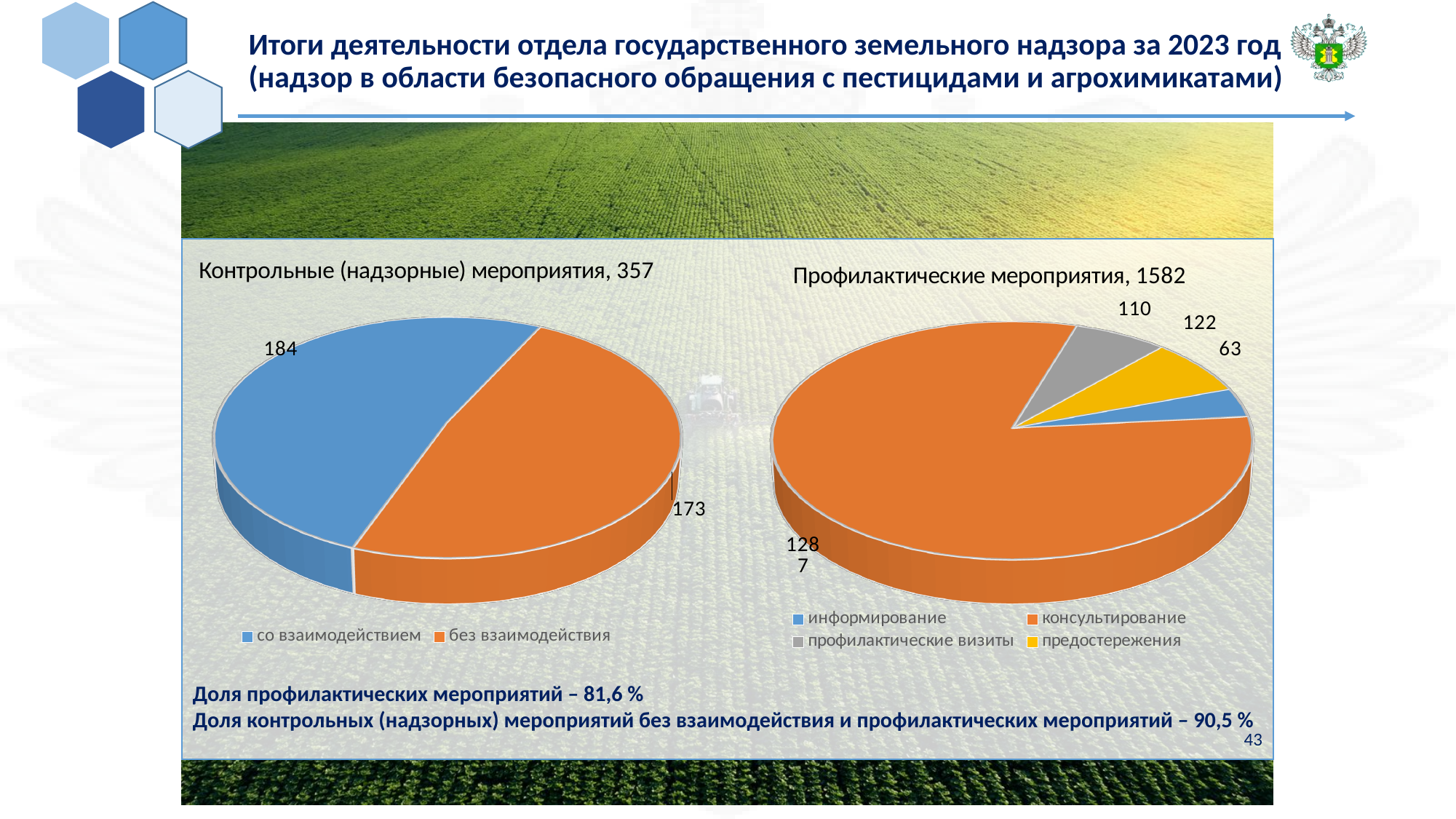
In the right chart 'Профилактические мероприятия', which category has the largest slice? консультирование In the left chart 'Контрольные (надзорные) мероприятия', what is the value for 'со взаимодействием'? 184 In the right chart 'Профилактические мероприятия', what is the value for 'информирование'? 63 How many categories does the legend of the right chart 'Профилактические мероприятия' list? 4 How many slices does the left chart 'Контрольные (надзорные) мероприятия' have? 2 In the left chart 'Контрольные (надзорные) мероприятия', what is the value for 'без взаимодействия'? 173 In the left chart 'Контрольные (надзорные) мероприятия', what is the difference between 'со взаимодействием' and 'без взаимодействия'? 11 In the right chart 'Профилактические мероприятия', what is the value for 'профилактические визиты'? 110 In the right chart 'Профилактические мероприятия', which category has the smallest slice? информирование In the right chart 'Профилактические мероприятия', what is the value for 'предостережения'? 122 In the left chart 'Контрольные (надзорные) мероприятия', which slice is larger: 'со взаимодействием' or 'без взаимодействия'? со взаимодействием What kind of chart is the left chart titled 'Контрольные (надзорные) мероприятия, 357'? pie chart